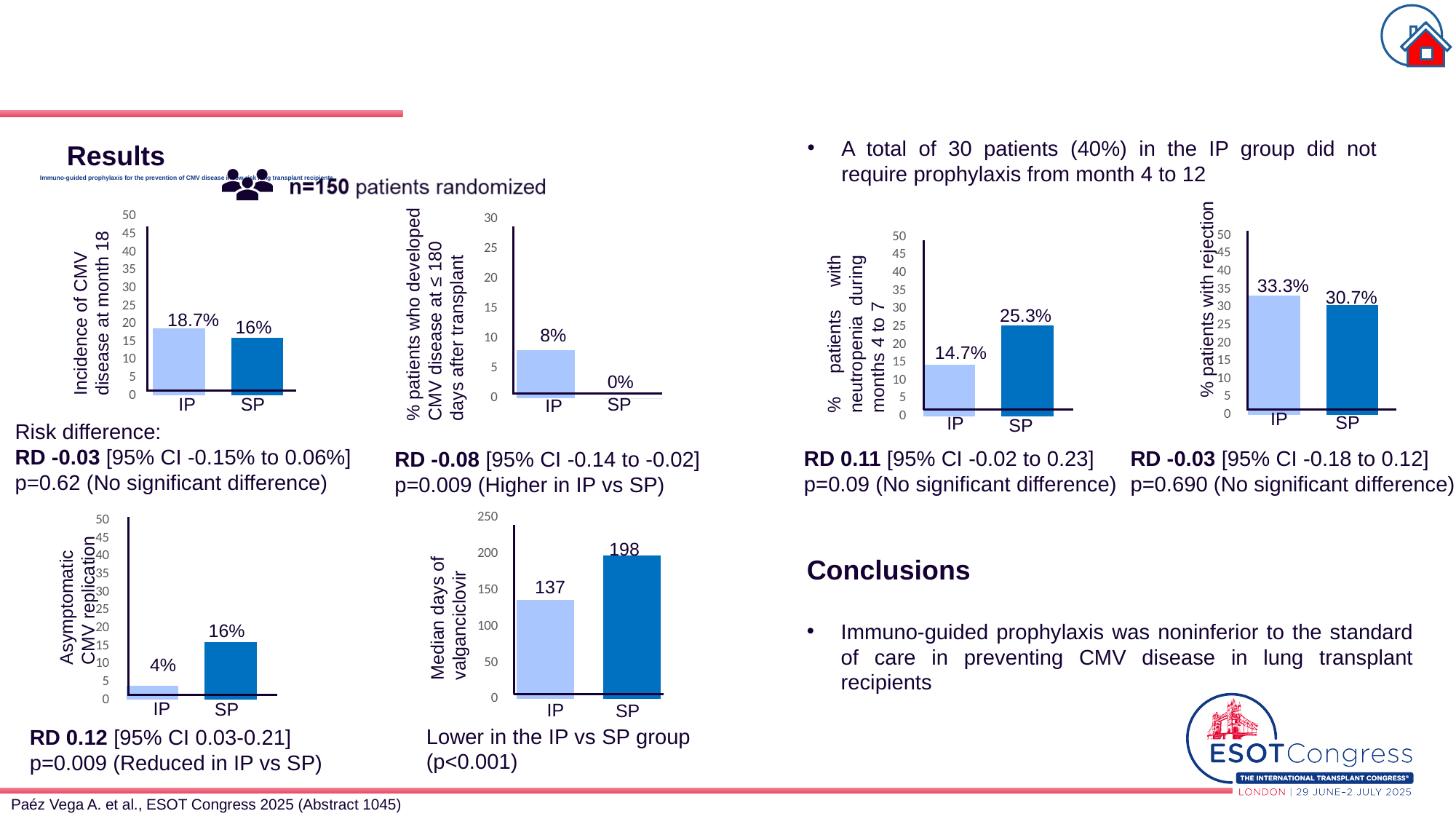
What kind of chart is used for median days of valganciclovir? Bar chart In the chart of % patients with rejection, what is the value for IP? 33.3% In the chart of % patients with neutropenia during months 4 to 7, what is the value for SP? 25.3% In the chart of asymptomatic CMV replication, what is the value for IP? 4% In the chart of incidence of CMV disease at month 18, what is the value for the SP group? 16% In the chart of % patients who developed CMV disease at ≤ 180 days after transplant, which group has the higher value? IP In the chart of median days of valganciclovir, what is the value for SP? 198 In the chart of % patients who developed CMV disease at ≤ 180 days after transplant, what is the value for SP? 0% In the chart of % patients with rejection, which group has the lower value? SP In the chart of incidence of CMV disease at month 18, what is the value for the IP group? 18.7% In the chart of median days of valganciclovir, what is the difference between the SP and IP values? 61 In the chart of % patients with neutropenia during months 4 to 7, what is the difference between the SP and IP values? 10.6%